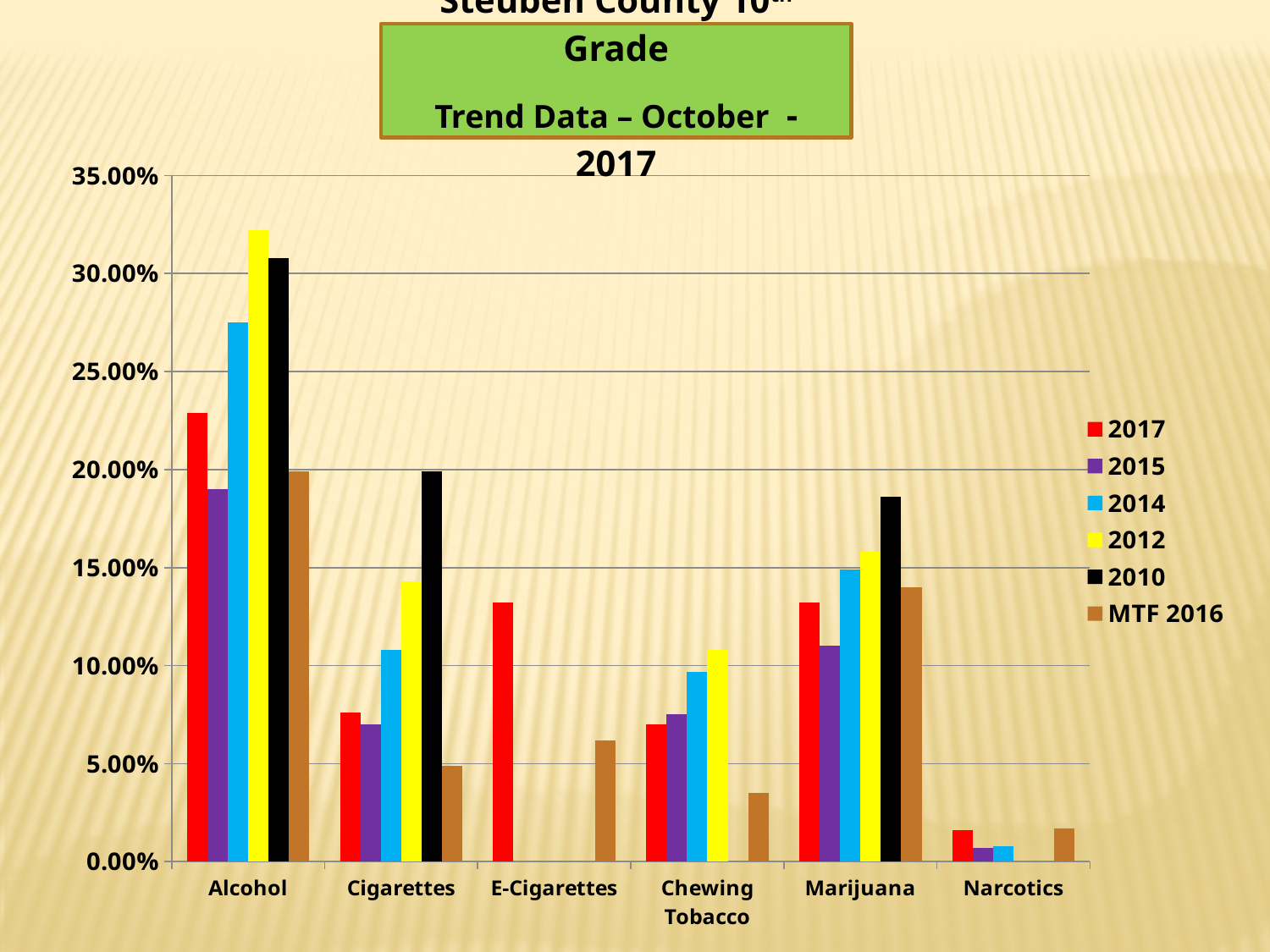
What kind of chart is shown on the slide? bar chart Within the Marijuana category, which series has the highest bar? 2010 Within the Alcohol category, which series has the highest bar? 2012 How many substance categories are shown on the x axis? 6 Which colour represents the 2010 series in the legend? black Is the 2017 value for E-Cigarettes greater or less than 10.00%? greater How many series does the legend list? 6 Is the 2017 value for Narcotics greater or less than 5.00%? less Which category has the lowest bars overall? Narcotics For Alcohol, which is larger: the 2017 value or the 2015 value? 2017 Is the 2012 value for Alcohol greater or less than 30.00%? greater Which category has the highest bar overall? Alcohol